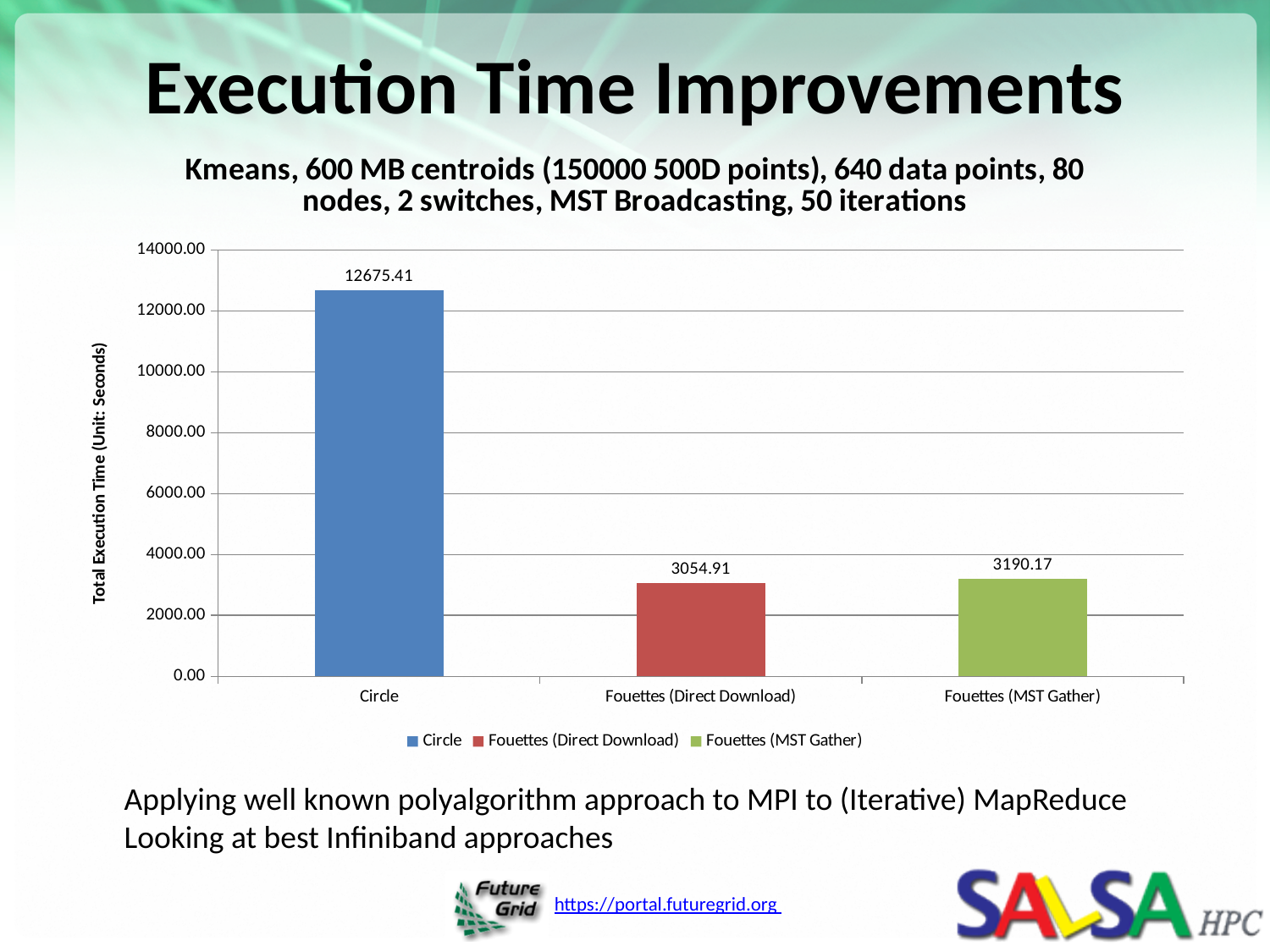
What is the total execution time for Fouettes (MST Gather)? 3190.17 What kind of chart is shown on the slide? Bar chart What is the difference in execution time between Circle and Fouettes (Direct Download)? 9620.50 Which category has the lowest total execution time? Fouettes (Direct Download) How many categories are shown on the x axis? 3 What is the difference in execution time between Fouettes (MST Gather) and Fouettes (Direct Download)? 135.26 Which has a larger execution time, Fouettes (Direct Download) or Fouettes (MST Gather)? Fouettes (MST Gather) What is the total execution time for Fouettes (Direct Download)? 3054.91 Is the value for Circle greater or less than 12000.00? greater Which category has the highest total execution time? Circle What is the label of the y axis? Total Execution Time (Unit: Seconds) What is the total execution time for Circle? 12675.41